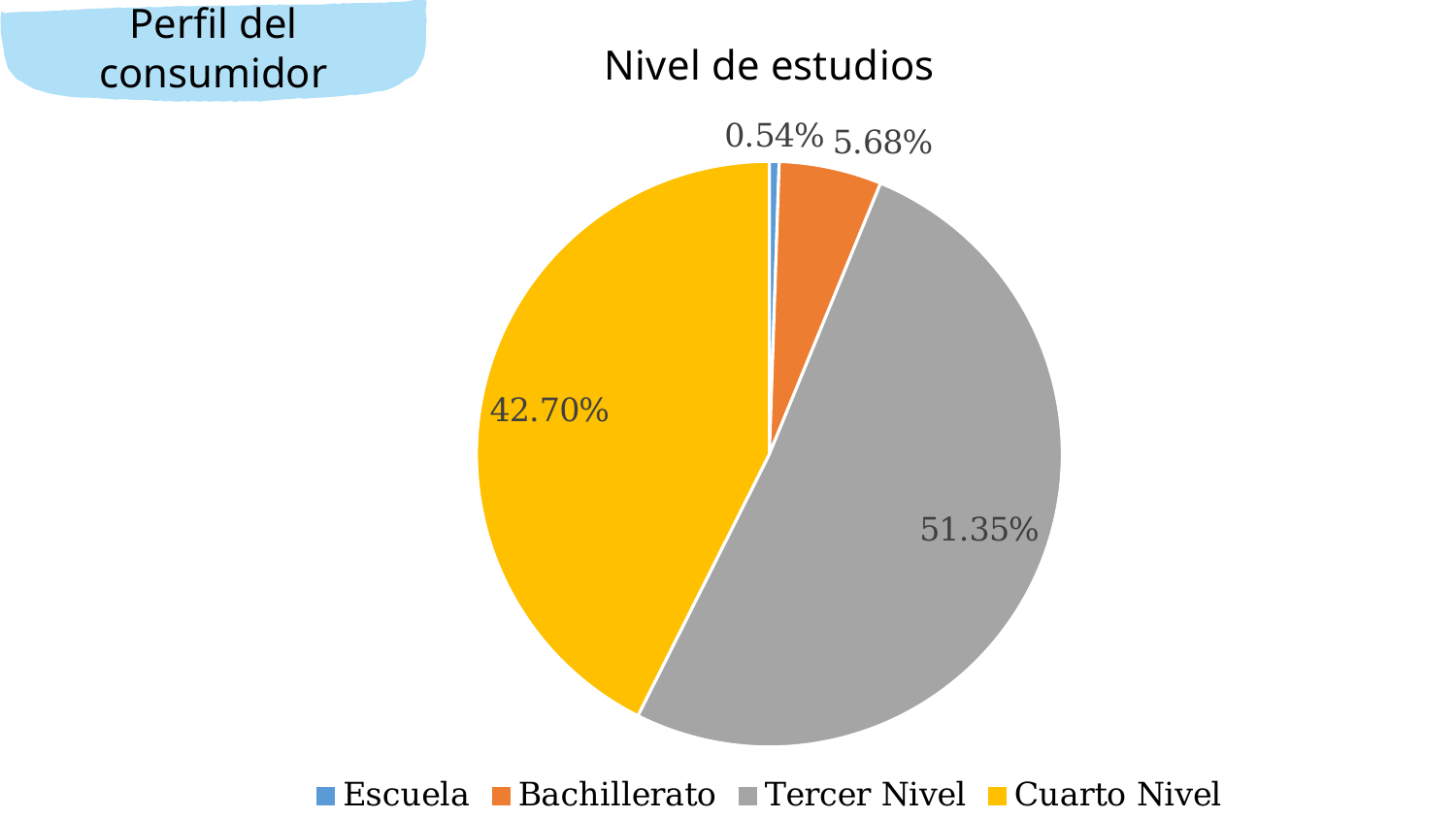
Which category has the smallest slice of the pie? Escuela What share of the pie does Tercer Nivel represent? 51.35% What is the value shown for Escuela? 0.54% What is the difference between the Tercer Nivel and Cuarto Nivel shares? 8.65% What share of the pie does Cuarto Nivel represent? 42.70% What is the title of the chart? Nivel de estudios What colour is the Cuarto Nivel slice? yellow How many categories does the legend list? 4 Which category has the largest slice of the pie? Tercer Nivel What is the value shown for Bachillerato? 5.68% What type of chart is shown on the slide? pie chart Which is larger, the share for Bachillerato or the share for Escuela? Bachillerato